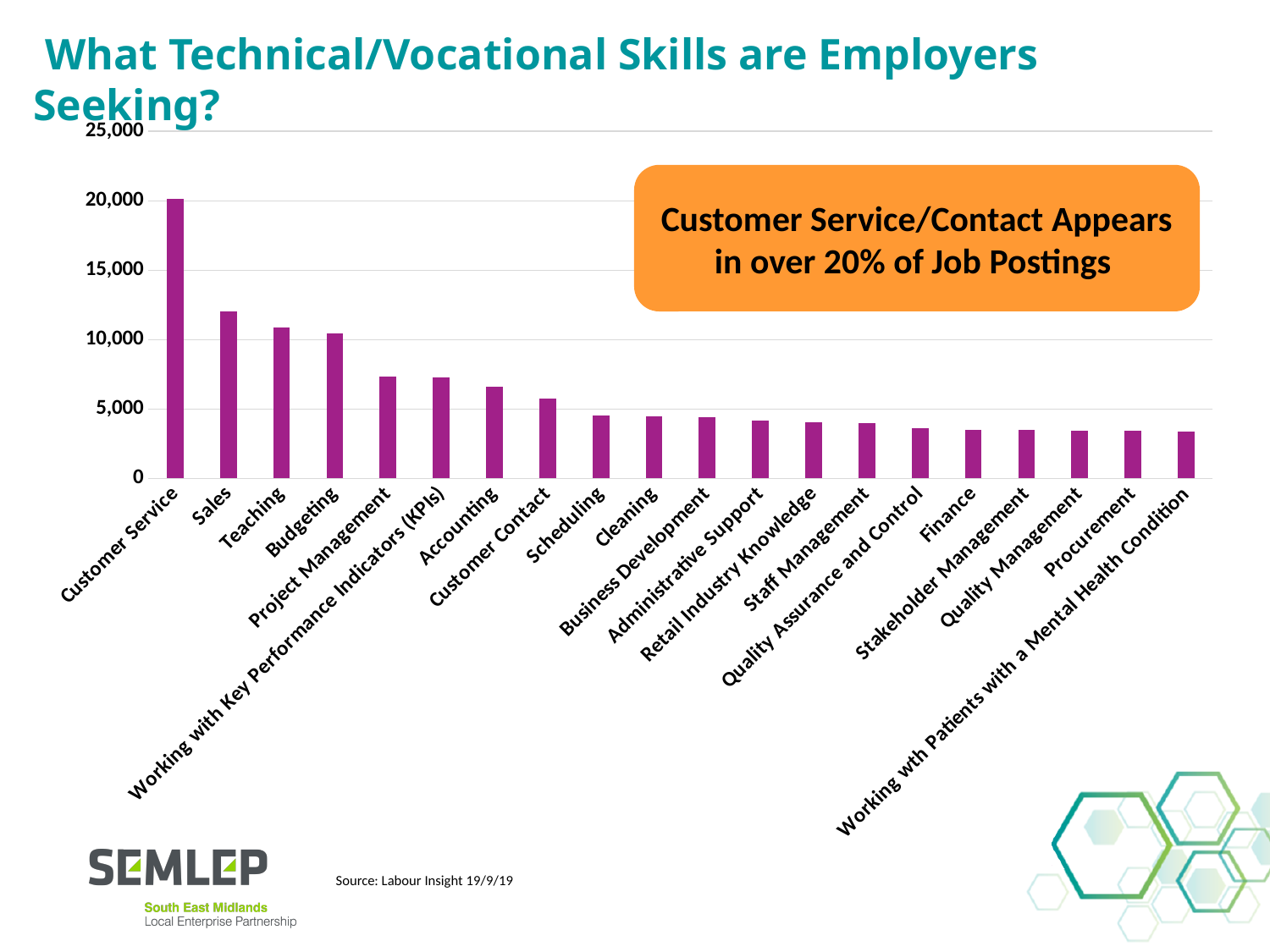
Which has a larger value, Sales or Teaching? Sales Is the value for Finance greater or less than 5,000? less Is the value for Accounting greater or less than 5,000? greater Is the value for Project Management greater or less than 10,000? less What kind of chart is shown on the slide? Bar chart Which skill has the highest value in the chart? Customer Service Which has a larger value, Budgeting or Project Management? Budgeting Do the bar values rise or fall moving from left to right along the x axis? Fall According to the callout box on the slide, Customer Service/Contact appears in over what percentage of job postings? 20% How many skill categories are plotted in the chart? 20